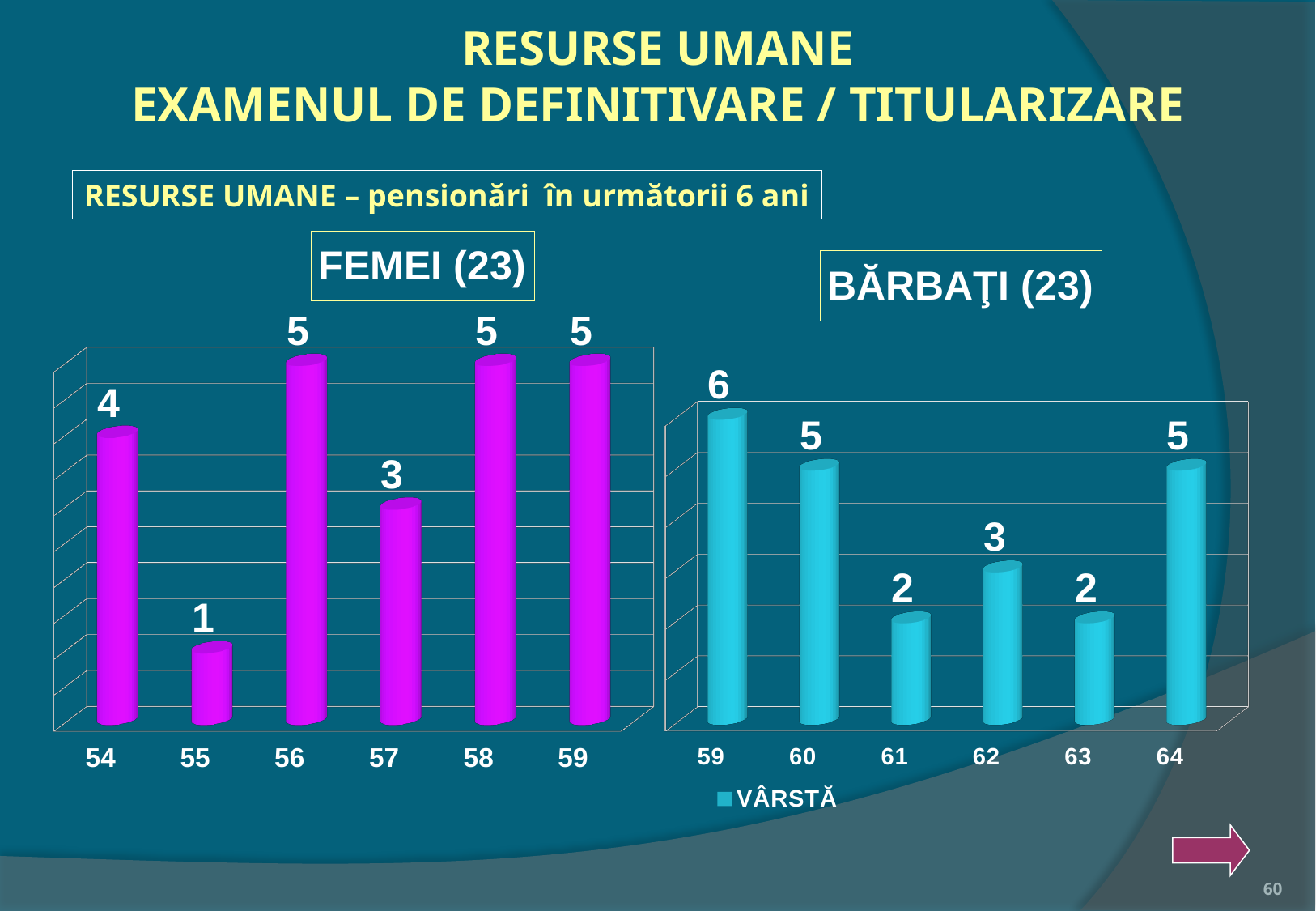
In the BĂRBAŢI (23) chart, what is the value for age 62? 3 In the FEMEI (23) chart, what is the value for age 55? 1 In the FEMEI (23) chart, what is the value for age 57? 3 What kind of chart is the BĂRBAŢI (23) chart? bar chart In the BĂRBAŢI (23) chart, which age has the highest value? 59 In the BĂRBAŢI (23) chart, what is the difference between the values for age 59 and age 61? 4 In the FEMEI (23) chart, which age has the lowest value? 55 In the BĂRBAŢI (23) chart, what is the value for age 64? 5 What is the legend entry shown below the BĂRBAŢI (23) chart? VÂRSTĂ In the FEMEI (23) chart, what is the difference between the values for age 56 and age 55? 4 How many age categories are shown in the FEMEI (23) chart? 6 In the BĂRBAŢI (23) chart, which is larger, the value for age 60 or the value for age 62? 60